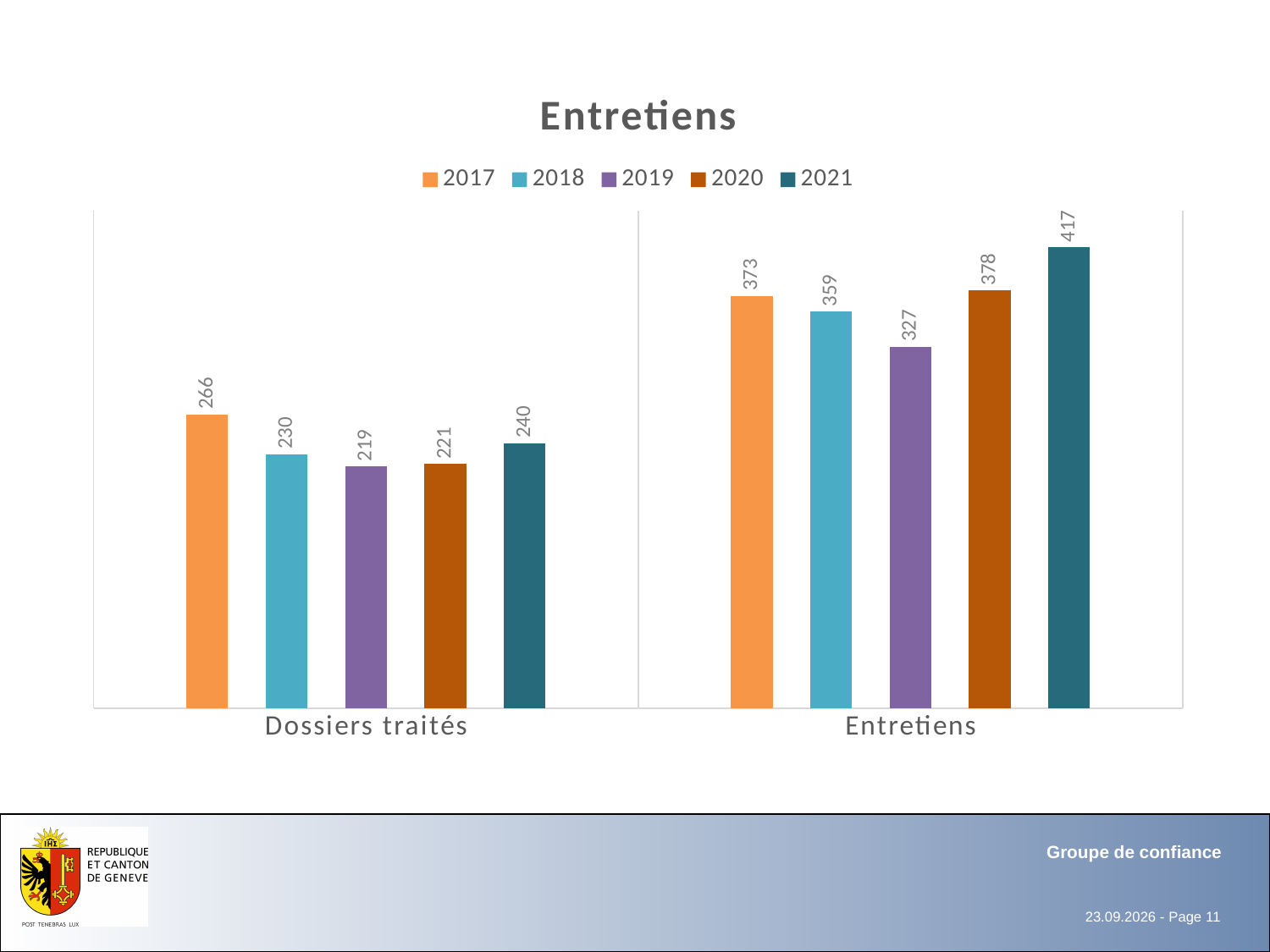
What is the title of the chart? Entretiens How many series does the legend list? 5 What is the difference between the 2021 and 2019 values in the Entretiens category? 90 What is the value for 2019 in the Entretiens category? 327 Which is larger in the Entretiens category, the value for 2018 or the value for 2020? 2020 How many categories are shown on the x axis? 2 What is the value for 2017 in the Dossiers traités category? 266 What is the value for 2021 in the Entretiens category? 417 Which year has the lowest value in the Dossiers traités category? 2019 Which year has the highest value in the Entretiens category? 2021 What is the difference between the 2017 and 2018 values in the Dossiers traités category? 36 What kind of chart is shown on the slide? Bar chart